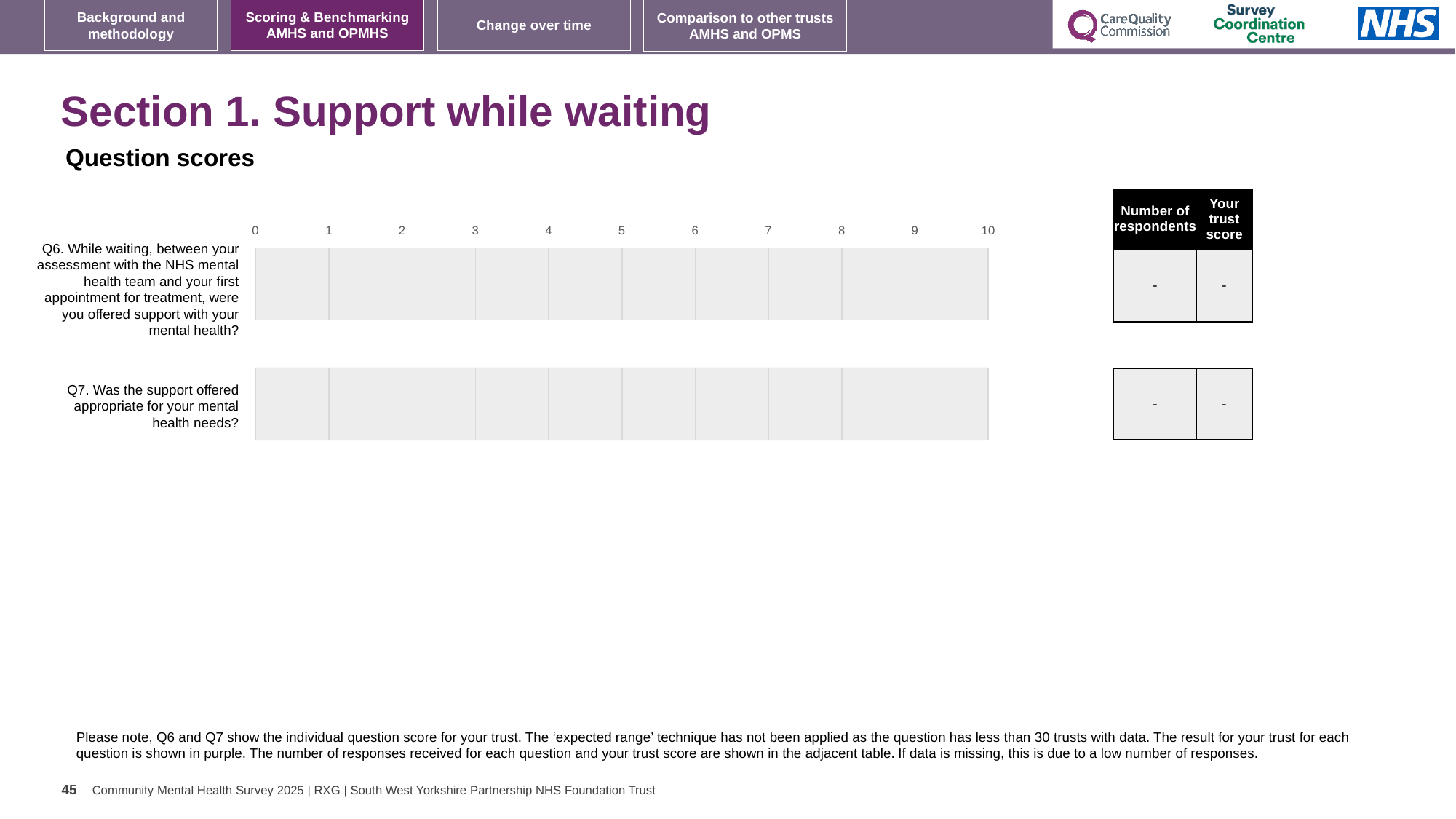
What is the 'Number of respondents' shown in the table for Q6? - What is the 'Your trust score' shown in the table for Q6? - How many questions (categories) are listed on the chart's vertical axis? 2 What is the 'Number of respondents' shown in the table for Q7? - What is the 'Your trust score' shown in the table for Q7? - What kind of chart is shown on the slide? bar chart Which question number is the first category listed on the chart? Q6 What is the highest value shown on the chart's horizontal axis? 10 What is the lowest value shown on the chart's horizontal axis? 0